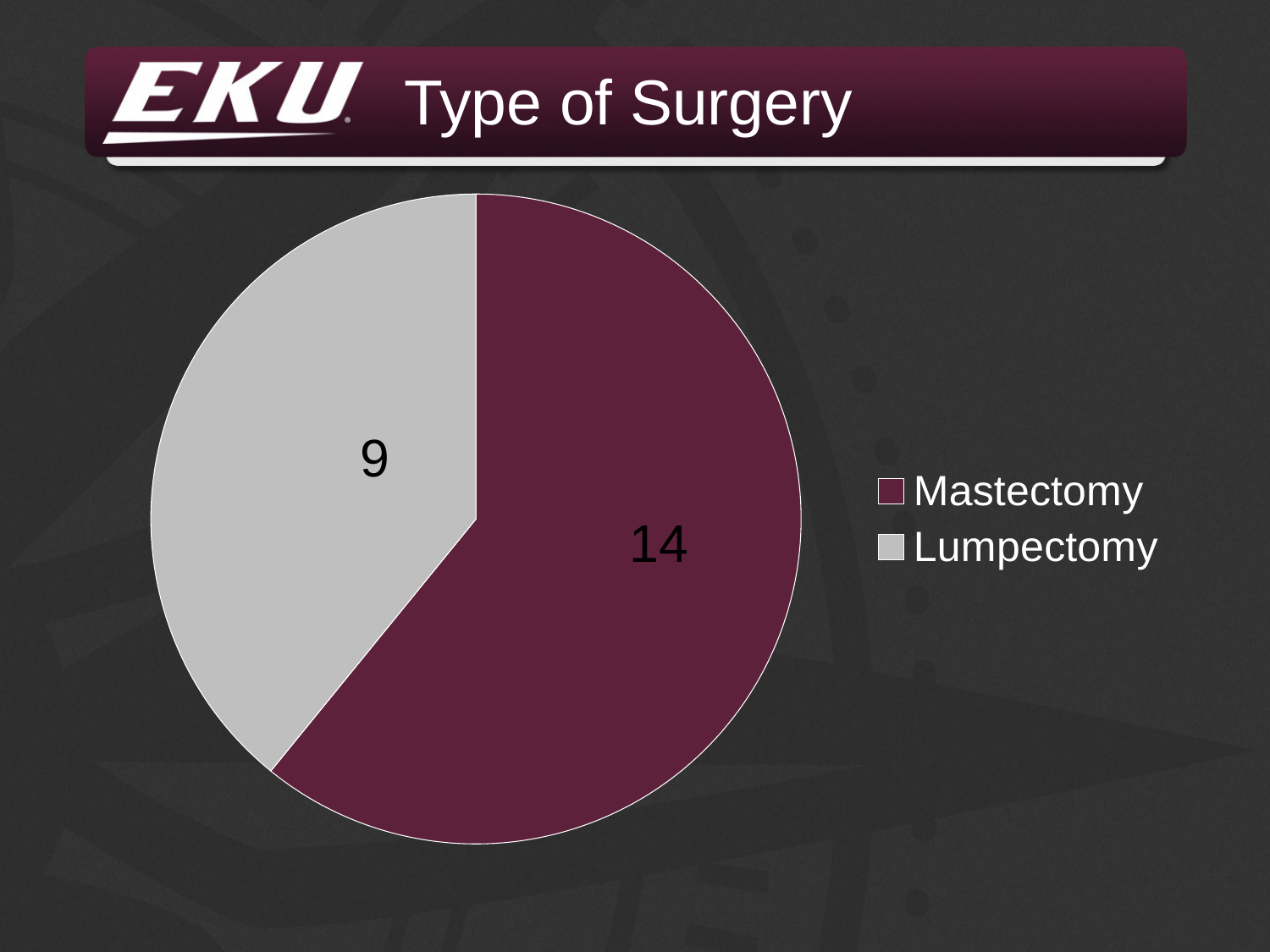
What is the difference between the Mastectomy and Lumpectomy values? 5 What is the value for Lumpectomy? 9 Which is larger, Mastectomy or Lumpectomy? Mastectomy What is the title of the slide? Type of Surgery What colour is the Lumpectomy slice? grey What is the value for Mastectomy? 14 What is the total of all slices in the pie chart? 23 How many slices does the pie chart have? 2 What type of chart is shown on the slide? pie chart Which type of surgery has the smallest slice? Lumpectomy Which type of surgery has the largest slice? Mastectomy